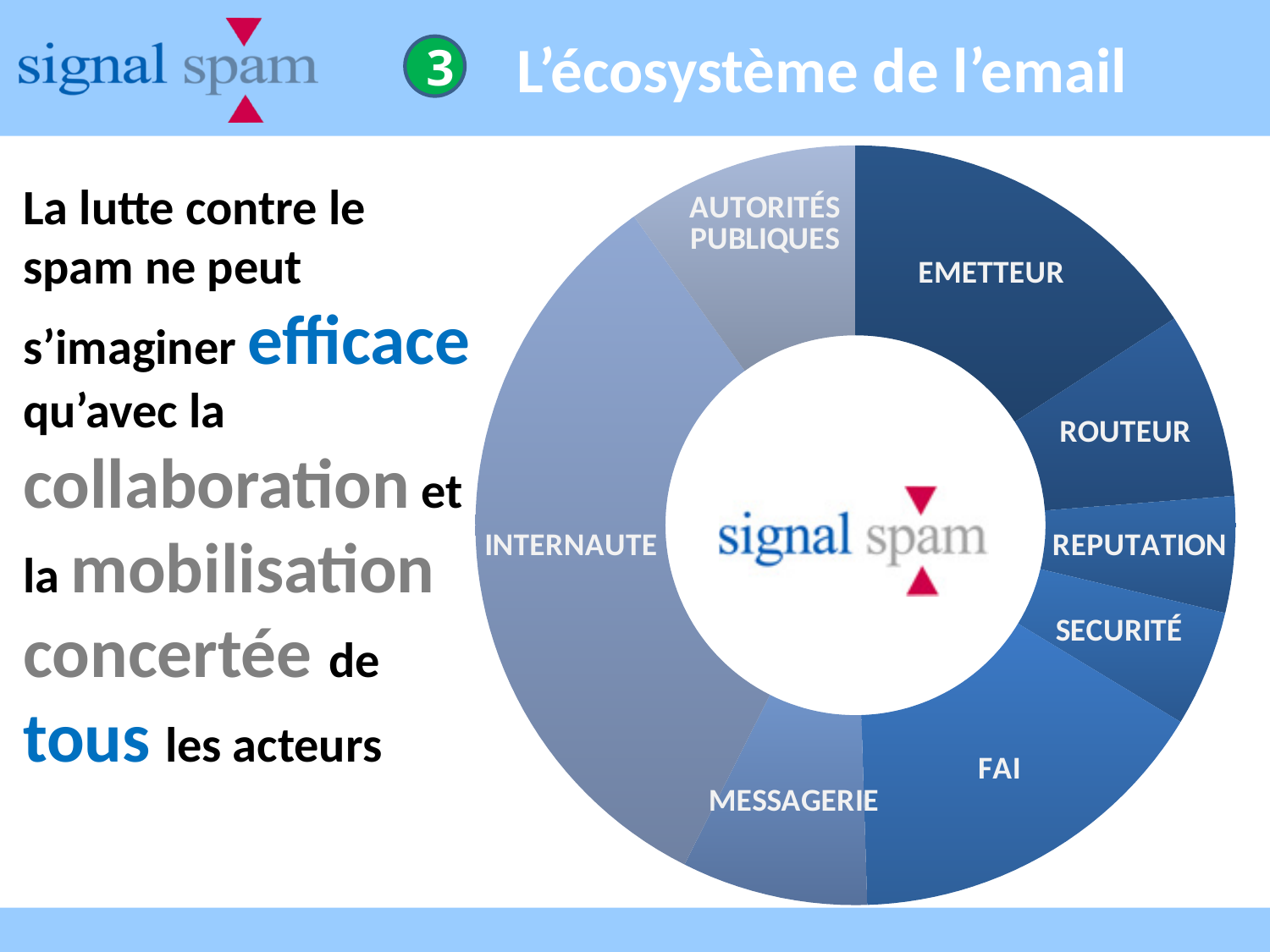
How many segments does the doughnut chart have? 8 What is the title of the slide containing the doughnut chart? L'écosystème de l'email Which segment is larger, EMETTEUR or ROUTEUR? EMETTEUR Which segment of the doughnut chart is the largest? INTERNAUTE Which segment is larger, INTERNAUTE or EMETTEUR? INTERNAUTE What kind of chart is shown on the slide? Doughnut chart Which segment is larger, FAI or SECURITÉ? FAI What logo appears in the centre of the doughnut chart? signal spam